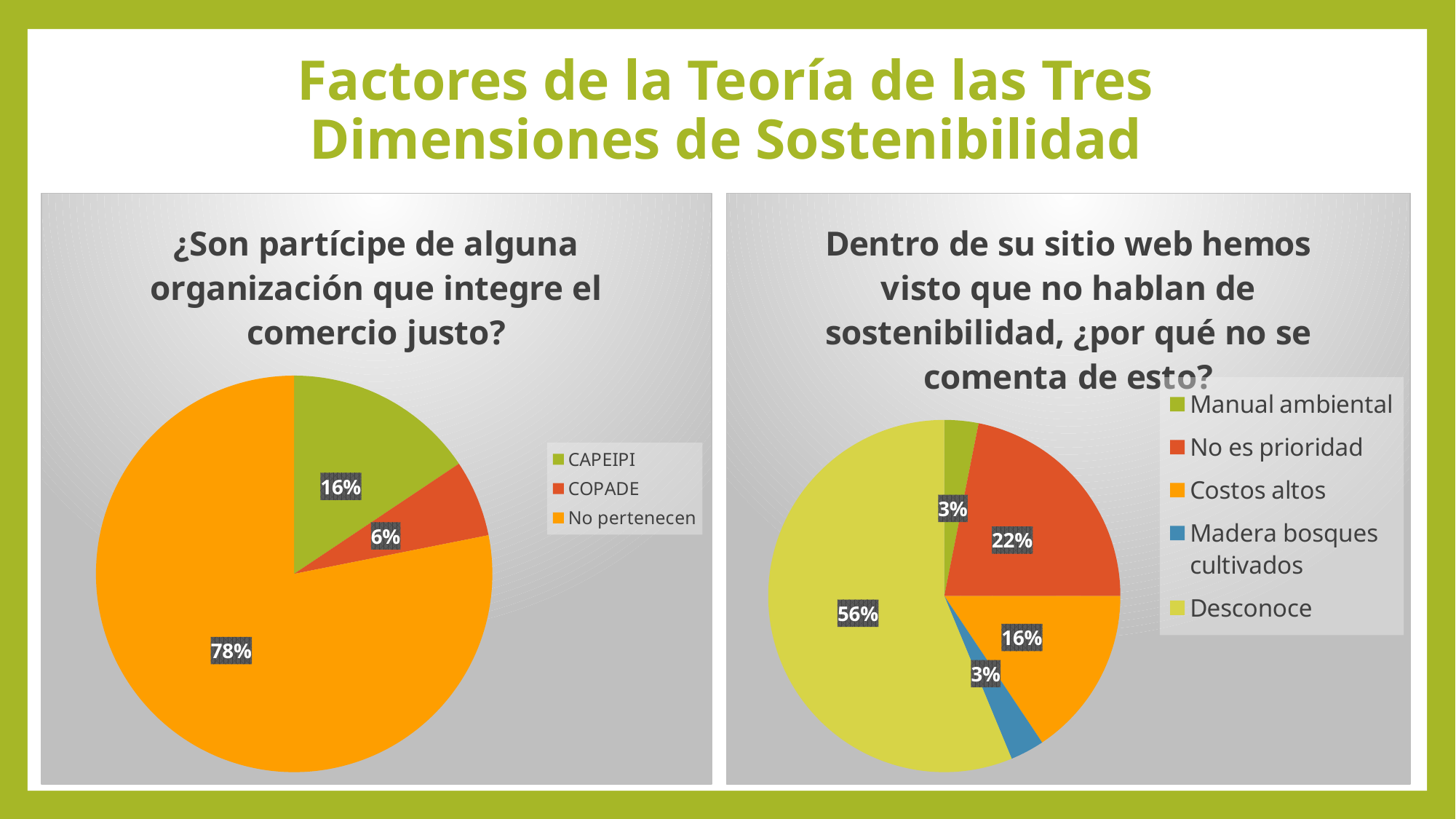
What type of chart is used on the right side of the slide? Pie chart In the left pie chart, what percentage is shown for COPADE? 6% In the left pie chart, how many categories does the legend list? 3 In the left pie chart, what is the difference in percentage points between No pertenecen and CAPEIPI? 62 In the left pie chart (¿Son partícipe de alguna organización que integre el comercio justo?), what share is labelled for No pertenecen? 78% In the right pie chart, how many categories does the legend list? 5 In the right pie chart, which category has the largest slice? Desconoce In the right pie chart (Dentro de su sitio web hemos visto que no hablan de sostenibilidad...), what percentage is shown for Desconoce? 56% In the right pie chart, which is larger, No es prioridad or Costos altos? No es prioridad In the left pie chart, what percentage is shown for CAPEIPI? 16% In the right pie chart, what percentage is shown for No es prioridad? 22% In the left pie chart, which category has the smallest slice? COPADE